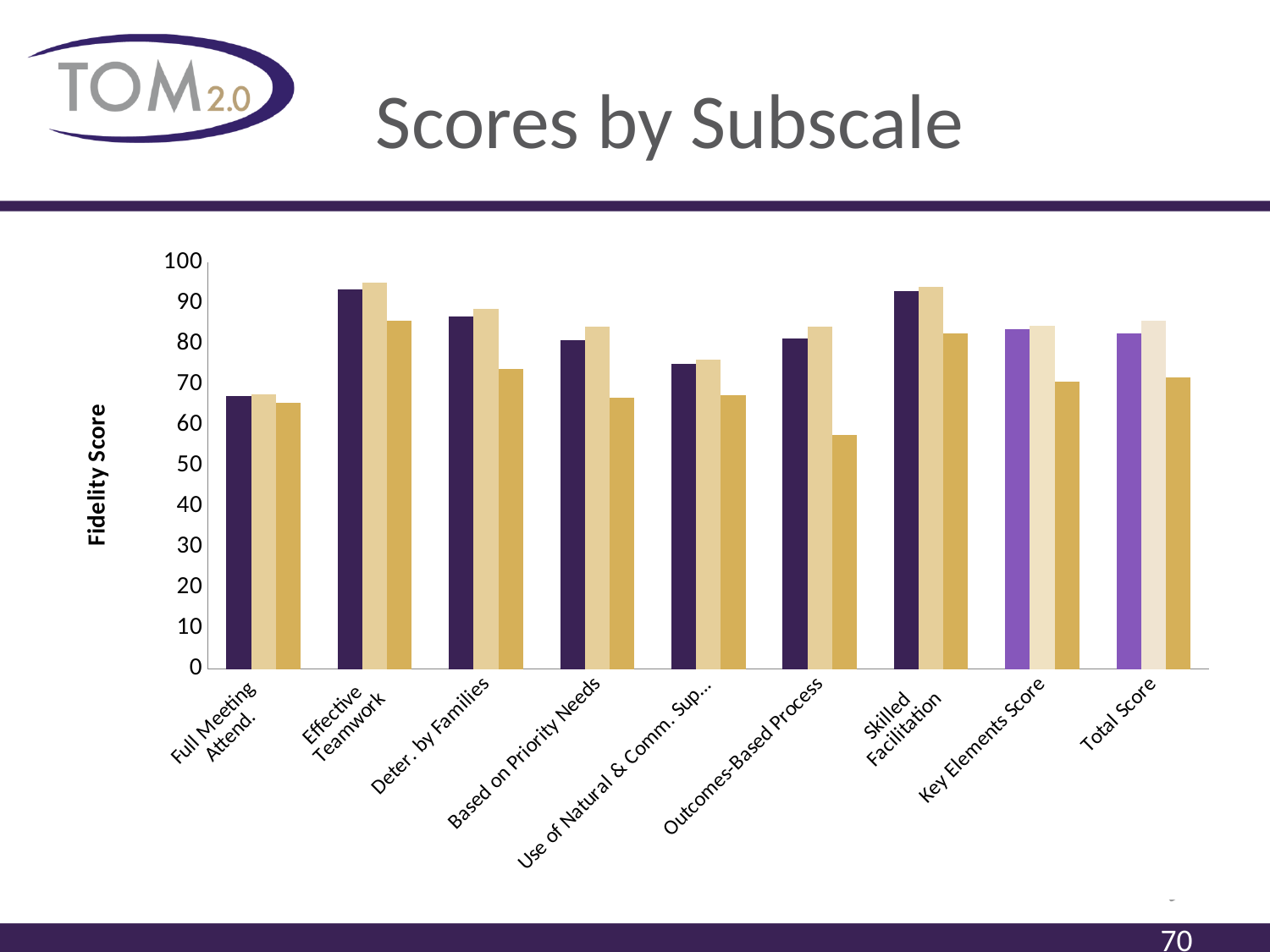
Is the value of the dark purple (first) bar for Effective Teamwork greater or less than 90? greater How many subscale categories are shown along the x axis of the chart? 9 Is the value of the dark purple (first) bar for Full Meeting Attend. greater or less than 70? less Which category has the lowest dark purple (first) bar in the chart? Full Meeting Attend. Which has the larger gold (third) bar: Deter. by Families or Based on Priority Needs? Deter. by Families Which category has the lowest gold (third) bar in the chart? Outcomes-Based Process Is the value of the gold (third) bar for Based on Priority Needs greater or less than 70? less How many bars are plotted for each category in the chart? 3 What is the label on the vertical axis of the chart? Fidelity Score What is the title of the slide containing the chart? Scores by Subscale What kind of chart is shown on the slide? bar chart